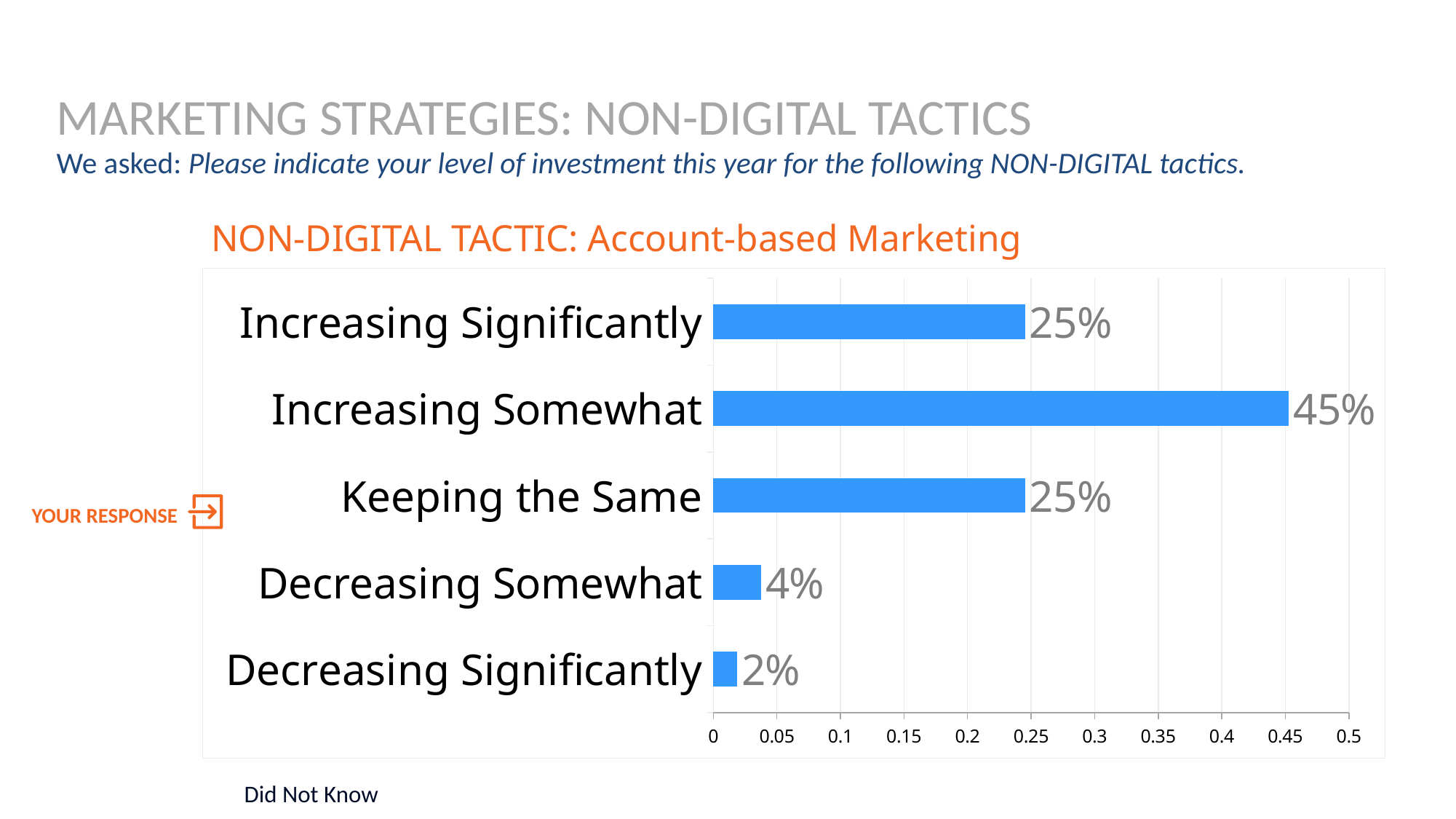
Which category has the lowest value? Decreasing Significantly Which is larger, the value for Decreasing Somewhat or Decreasing Significantly? Decreasing Somewhat Which category has the highest value? Increasing Somewhat What is the highest tick value shown on the x axis? 0.5 What is the difference between the values for Increasing Somewhat and Increasing Significantly? 20% What is the value shown for Decreasing Somewhat? 4% How many categories are shown in the chart? 5 What is the value shown for Keeping the Same? 25% What is the value shown for Decreasing Significantly? 2% What is the title of the chart? NON-DIGITAL TACTIC: Account-based Marketing What percentage of respondents are Increasing Somewhat their investment in Account-based Marketing? 45% What kind of chart is shown on the slide? Bar chart